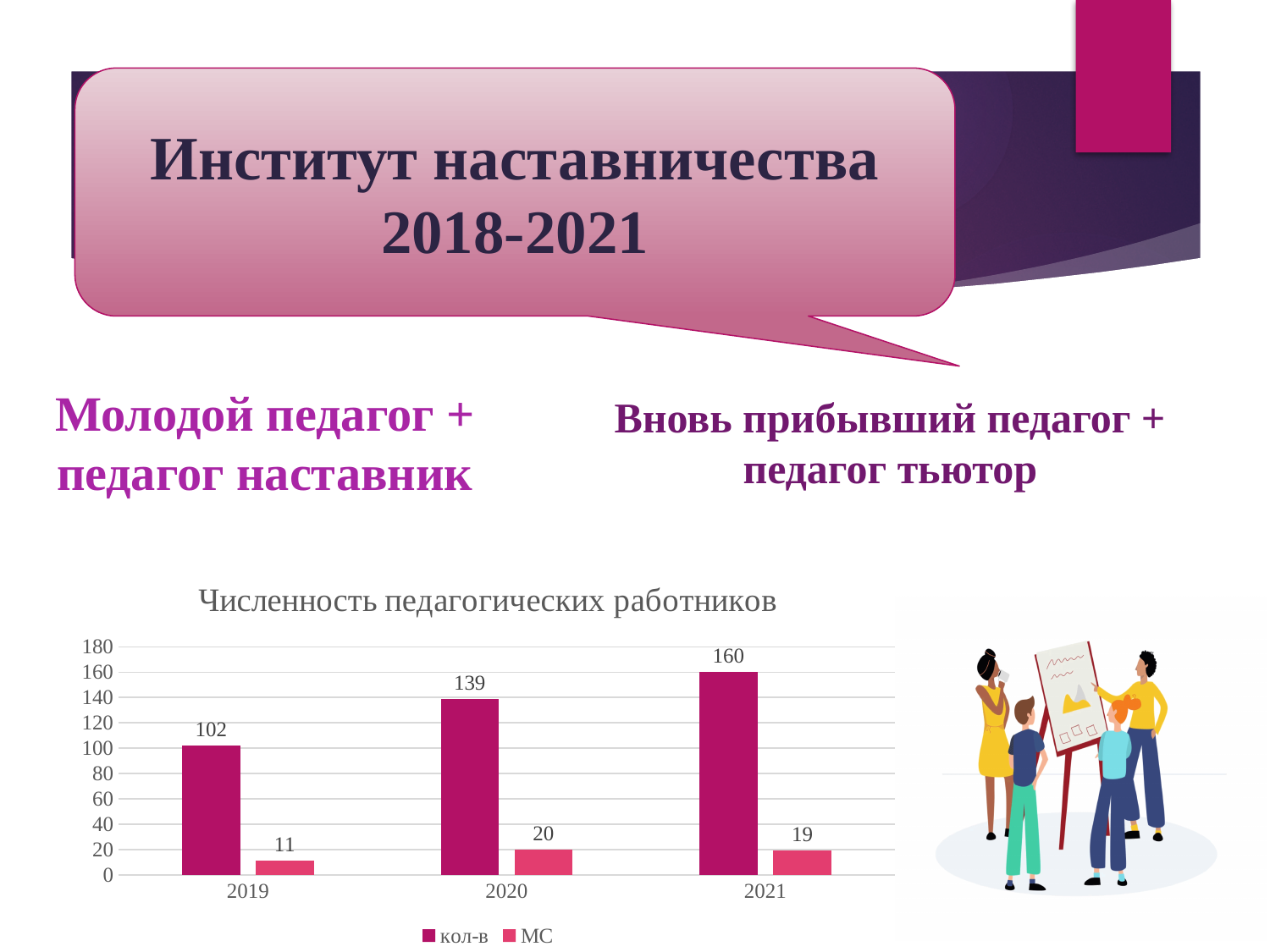
What is the value of the кол-в series for 2021? 160 How many years are shown on the x axis of the chart? 3 What kind of chart is shown on the slide? bar chart What is the value of the кол-в series for 2019? 102 What is the value of the МС series for 2020? 20 What is the title of the chart? Численность педагогических работников Which is larger: the МС value for 2020 or for 2021? 2020 Is the кол-в value for 2020 greater or less than 120? greater How many series does the chart legend list? 2 What is the difference between the кол-в values for 2021 and 2019? 58 Which year has the lowest value for the МС series? 2019 Which year has the highest value for the кол-в series? 2021